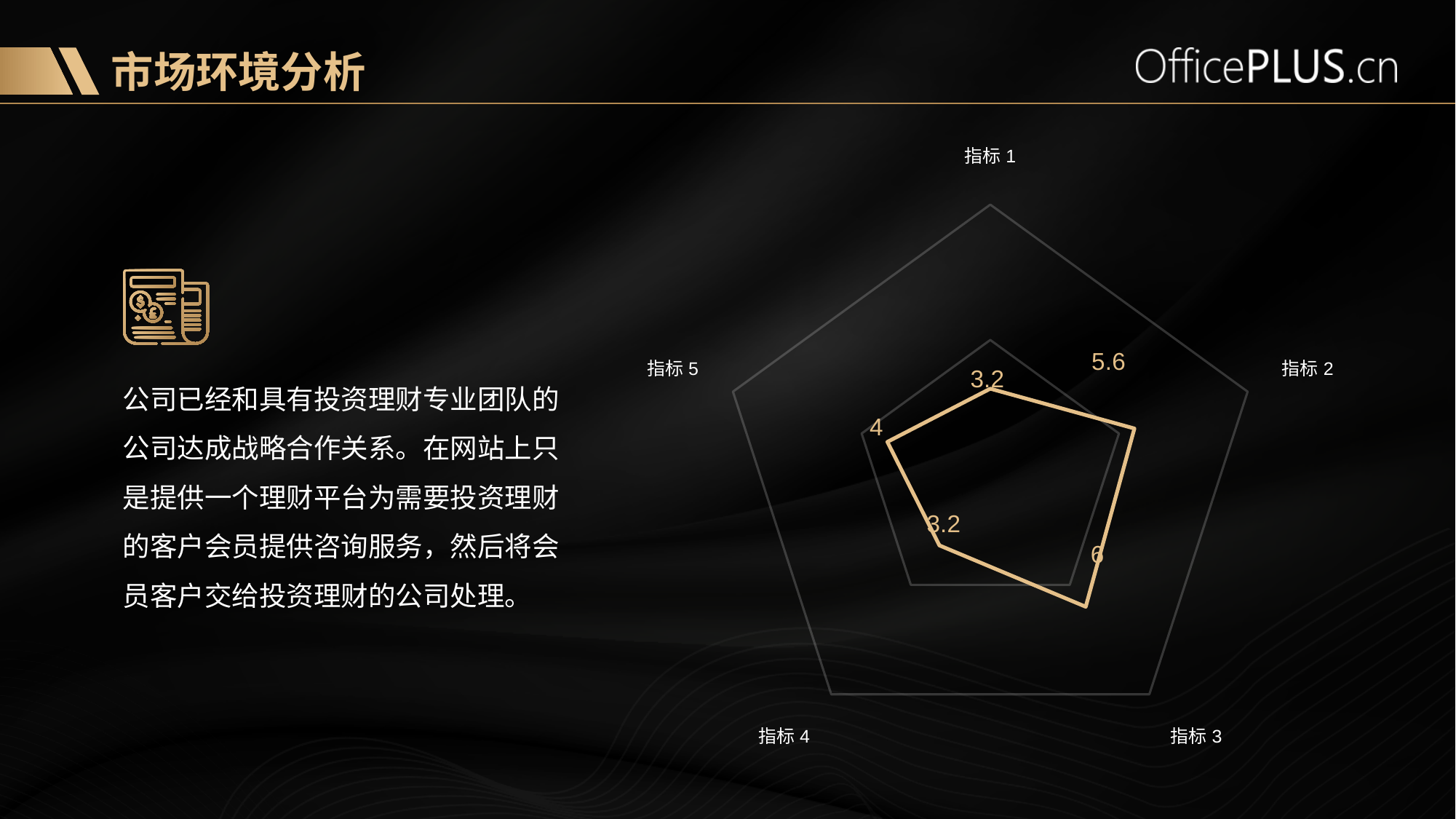
What is the value for 指标 5? 4 What is the value for 指标 2? 5.6 How many categories does the radar chart have? 5 What is the value for 指标 3? 6 Which is larger, the value for 指标 2 or the value for 指标 5? 指标 2 What type of chart is shown on the slide? Radar chart Which is larger, the value for 指标 5 or the value for 指标 4? 指标 5 Which category has the highest value? 指标 3 What is the value for 指标 4? 3.2 What is the difference between the values for 指标 2 and 指标 5? 1.6 What is the value for 指标 1? 3.2 What is the difference between the values for 指标 3 and 指标 1? 2.8